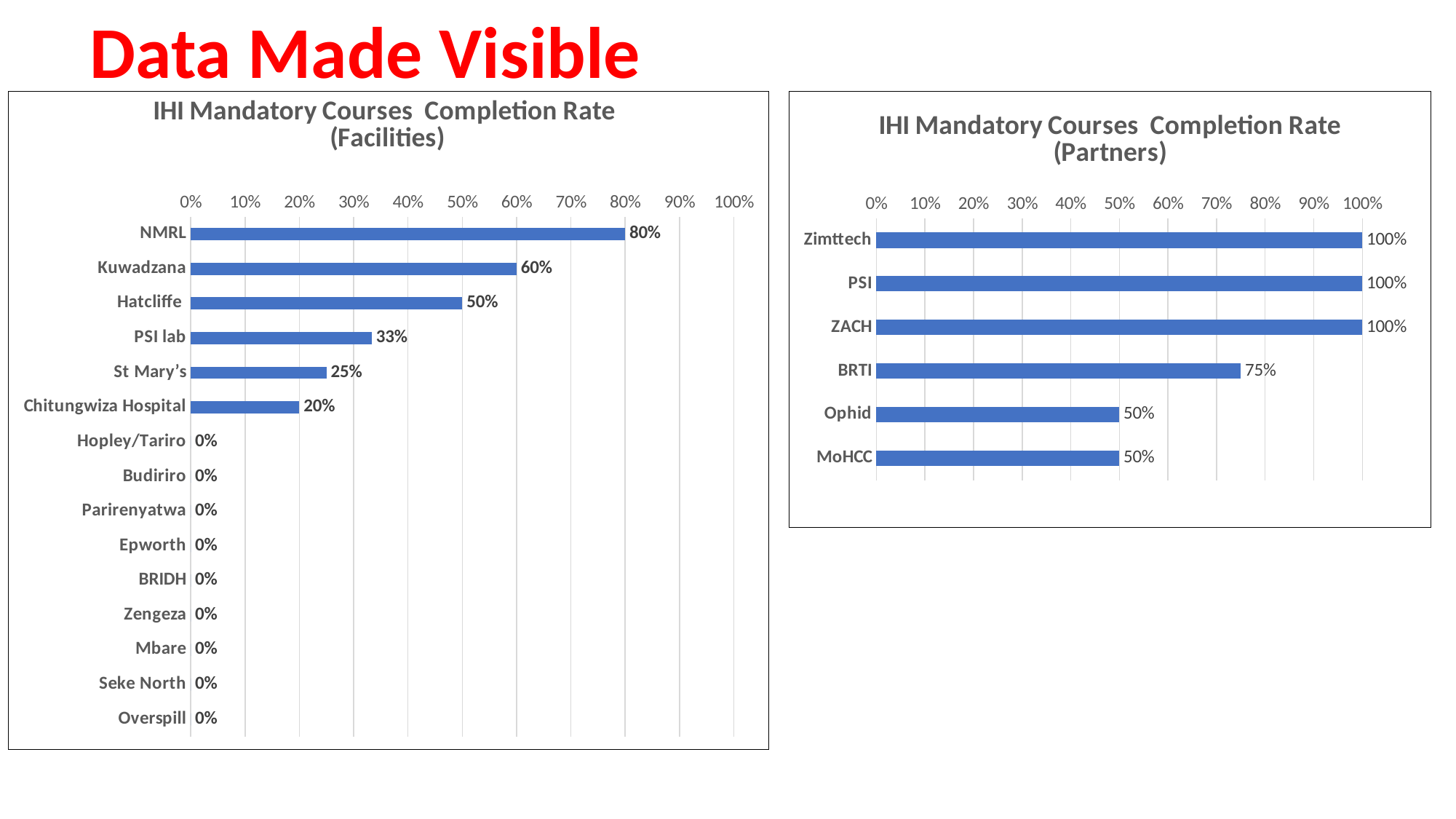
In the Facilities chart, how many facilities are listed? 15 In the Facilities chart, how many facilities have a completion rate of 0%? 9 In the Partners chart, what is the completion rate for Ophid? 50% What kind of chart is the Partners chart? Bar chart In the Partners chart, how many partners are listed? 6 In the Partners chart, what is the completion rate for BRTI? 75% In the Partners chart, what is the difference between the completion rates of ZACH and MoHCC? 50% In the Facilities chart, what is the completion rate for PSI lab? 33% In the Facilities chart, what is the difference between the completion rates of Kuwadzana and Hatcliffe? 10% In the Facilities chart, which has the higher completion rate, St Mary's or Chitungwiza Hospital? St Mary's In the Facilities chart, what is the completion rate for NMRL? 80% In the Facilities chart, which facility has the highest completion rate? NMRL